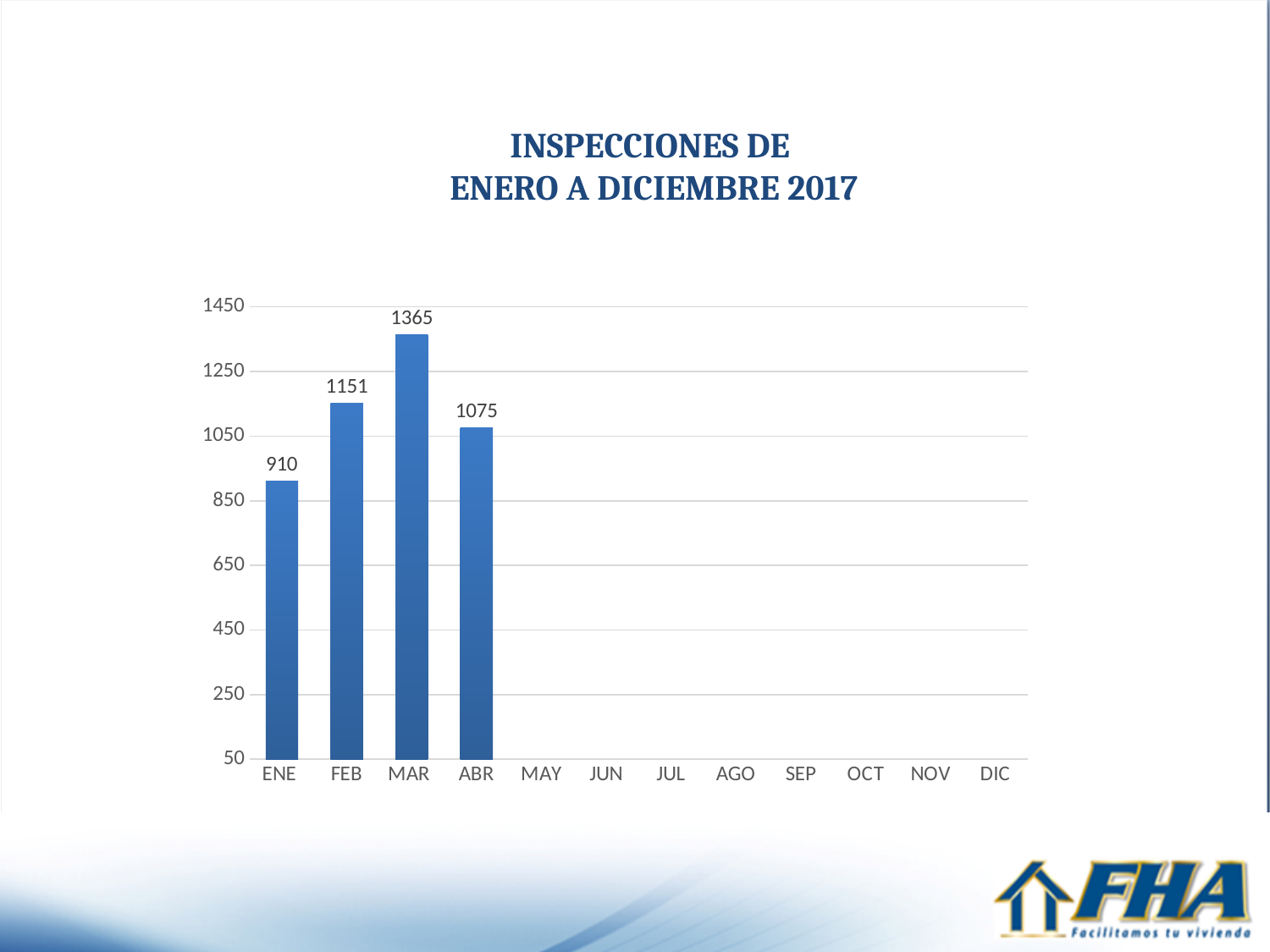
What is the difference between the values for FEB and ABR? 76 What is the value for FEB? 1151 Which month has the highest value? MAR Which is larger, the value for FEB or the value for ABR? FEB What is the value for ABR? 1075 What kind of chart is shown on the slide? Bar chart How many months are labelled on the x axis? 12 What is the value for MAR? 1365 How many months have a bar plotted? 4 What is the value for ENE? 910 Which month with a plotted bar has the lowest value? ENE What is the difference between the values for MAR and ENE? 455